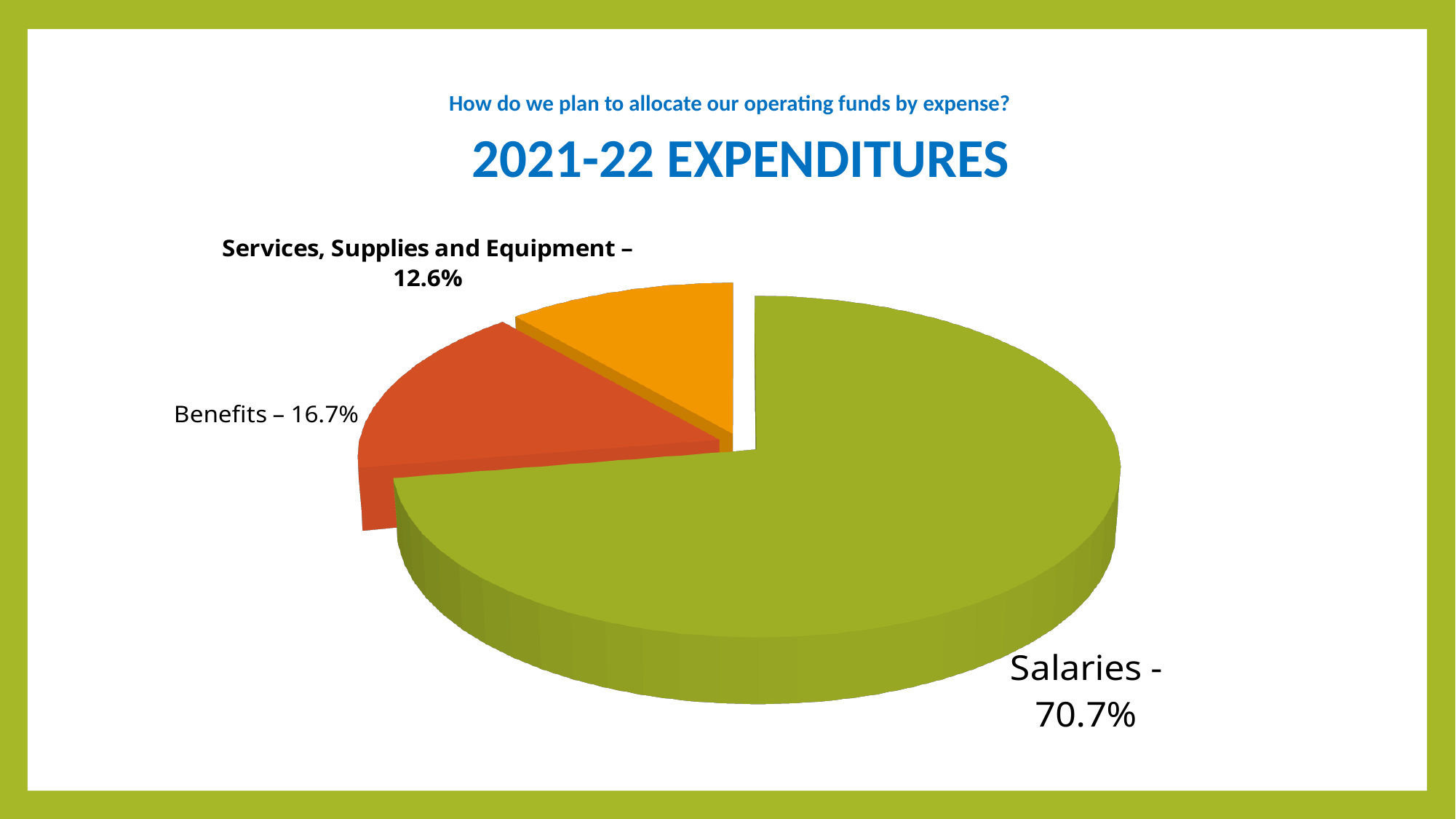
What is the difference in percentage points between the Benefits share and the Services, Supplies and Equipment share? 4.1 percentage points What is the difference in percentage points between the Salaries share and the Benefits share? 54 percentage points What colour is the Salaries slice of the pie? Green What share of 2021-22 expenditures goes to Benefits? 16.7% How many expense categories are shown in the pie chart? 3 Which is larger, the share for Benefits or the share for Services, Supplies and Equipment? Benefits Which expense category has the smallest share of the pie? Services, Supplies and Equipment What is the title of the chart? 2021-22 EXPENDITURES Which expense category has the largest share of the pie? Salaries What share of 2021-22 expenditures goes to Salaries? 70.7% What kind of chart is shown on the slide? Pie chart What share of 2021-22 expenditures goes to Services, Supplies and Equipment? 12.6%